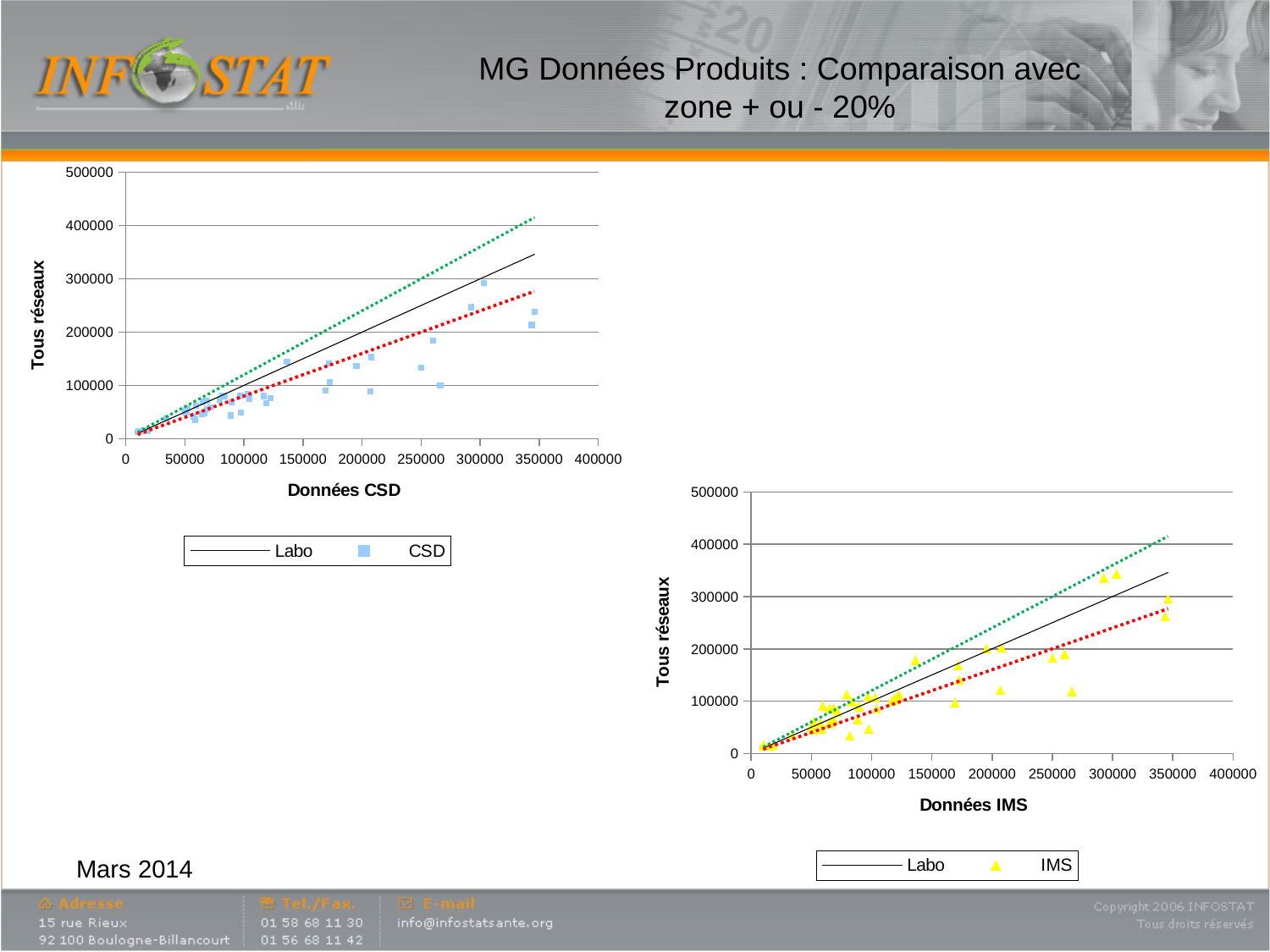
How many series does the legend of the left chart list? 2 In the left chart, do the CSD points generally rise or fall as the x-axis values increase? rise In the right chart, is the y value of the IMS point plotted near x = 265000 greater or less than 200000? less How many series does the legend of the right chart list? 2 What is the maximum value shown on the y-axis of the left chart? 500000 What kind of chart is the chart on the left of the slide? scatter chart In the right chart, do the IMS points generally rise or fall as the x-axis values increase? rise In the right chart, is the y value of the highest IMS point greater or less than 200000? greater In the left chart, is the y value of the highest CSD point greater or less than 200000? greater What is the x-axis title of the left chart? Données CSD What kind of chart is the chart on the right of the slide? scatter chart What is the x-axis title of the right chart? Données IMS